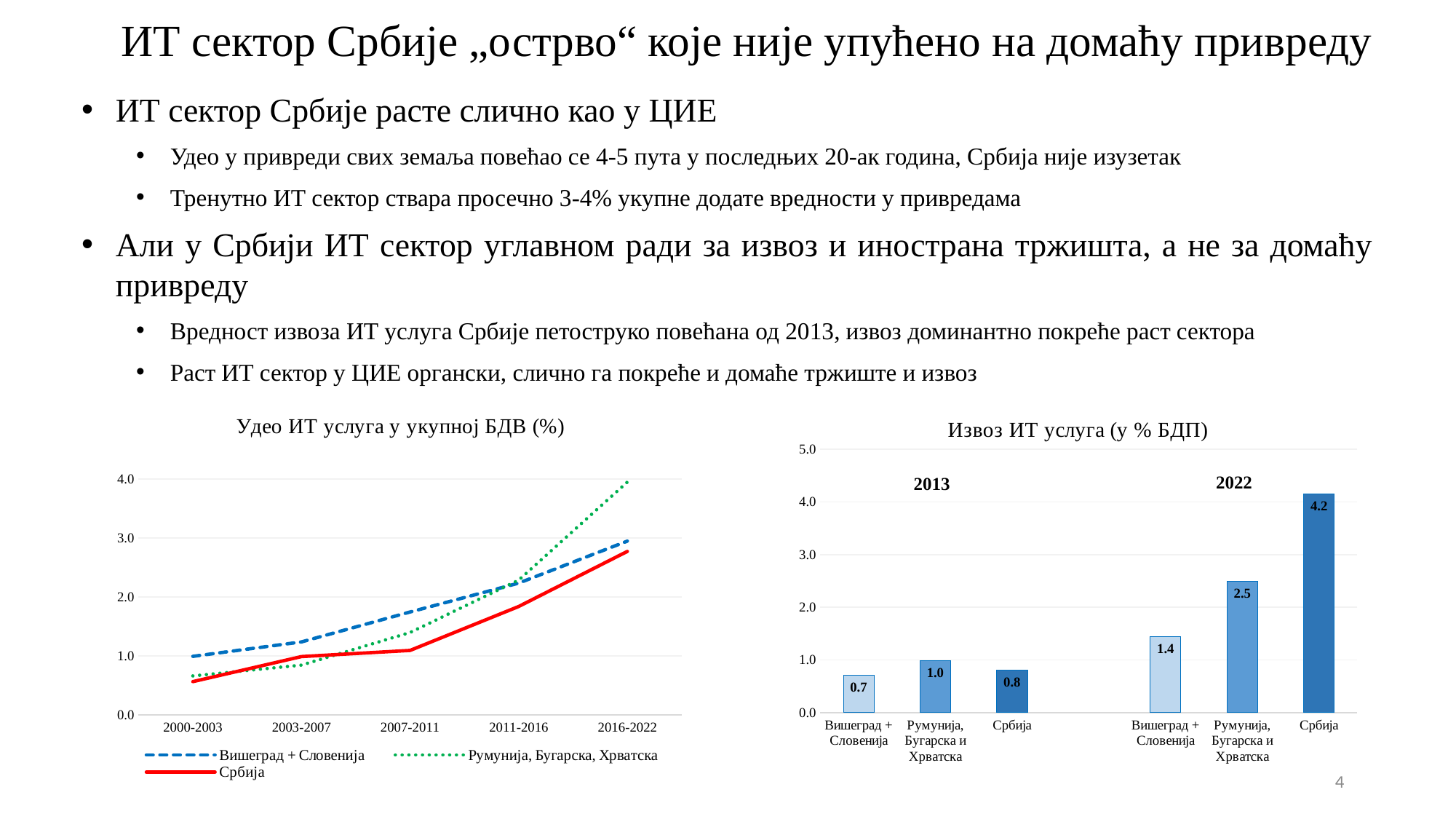
In the chart titled "Извоз ИТ услуга (у % БДП)", how many bars are plotted? 6 In the chart titled "Извоз ИТ услуга (у % БДП)", what is the value for Вишеград + Словенија in 2013? 0.7 What kind of chart is the chart titled "Удео ИТ услуга у укупној БДВ (%)"? Line chart In the chart titled "Извоз ИТ услуга (у % БДП)", which bar is the lowest? Вишеград + Словенија (2013) In the chart titled "Извоз ИТ услуга (у % БДП)", what is the difference between the value for Србија in 2022 and in 2013? 3.4 In the chart titled "Извоз ИТ услуга (у % БДП)", which is larger in 2013: Румунија, Бугарска и Хрватска or Србија? Румунија, Бугарска и Хрватска In the chart titled "Удео ИТ услуга у укупној БДВ (%)", is the value for Румунија, Бугарска, Хрватска in 2016-2022 greater or less than 3.0? greater In the chart titled "Извоз ИТ услуга (у % БДП)", what is the value for Румунија, Бугарска и Хрватска in 2022? 2.5 In the chart titled "Извоз ИТ услуга (у % БДП)", what is the value for Србија in 2022? 4.2 In the chart titled "Удео ИТ услуга у укупној БДВ (%)", how many series does the legend list? 3 In the chart titled "Удео ИТ услуга у укупној БДВ (%)", does the Србија line rise or fall from 2000-2003 to 2016-2022? Rises In the chart titled "Извоз ИТ услуга (у % БДП)", which bar is the highest? Србија (2022)